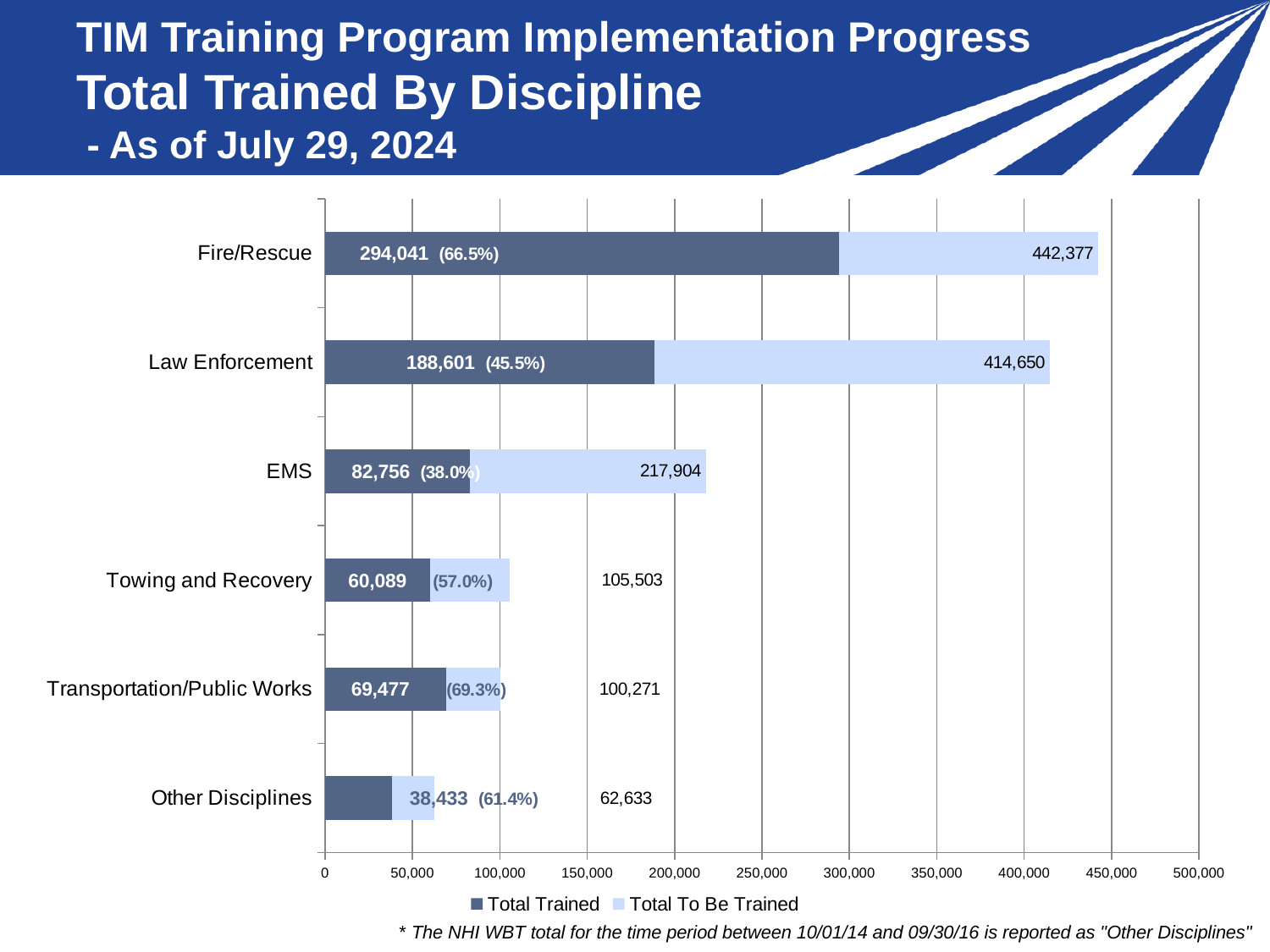
What is the Total Trained value for Law Enforcement? 188,601 What is the total value shown at the end of the Other Disciplines bar? 62,633 What is the Total Trained value for Fire/Rescue? 294,041 What is the difference between the Total Trained values for Fire/Rescue and Law Enforcement? 105,440 What percentage is shown next to the Total Trained value for EMS? 38.0% How many series does the legend list? 2 Which discipline has the lowest Total Trained value? Other Disciplines What is the total value shown at the end of the Towing and Recovery bar? 105,503 Which has a larger Total Trained value, Towing and Recovery or Transportation/Public Works? Transportation/Public Works What kind of chart is shown on the slide? Stacked bar chart How many disciplines are shown on the chart? 6 Which discipline has the highest Total Trained value? Fire/Rescue